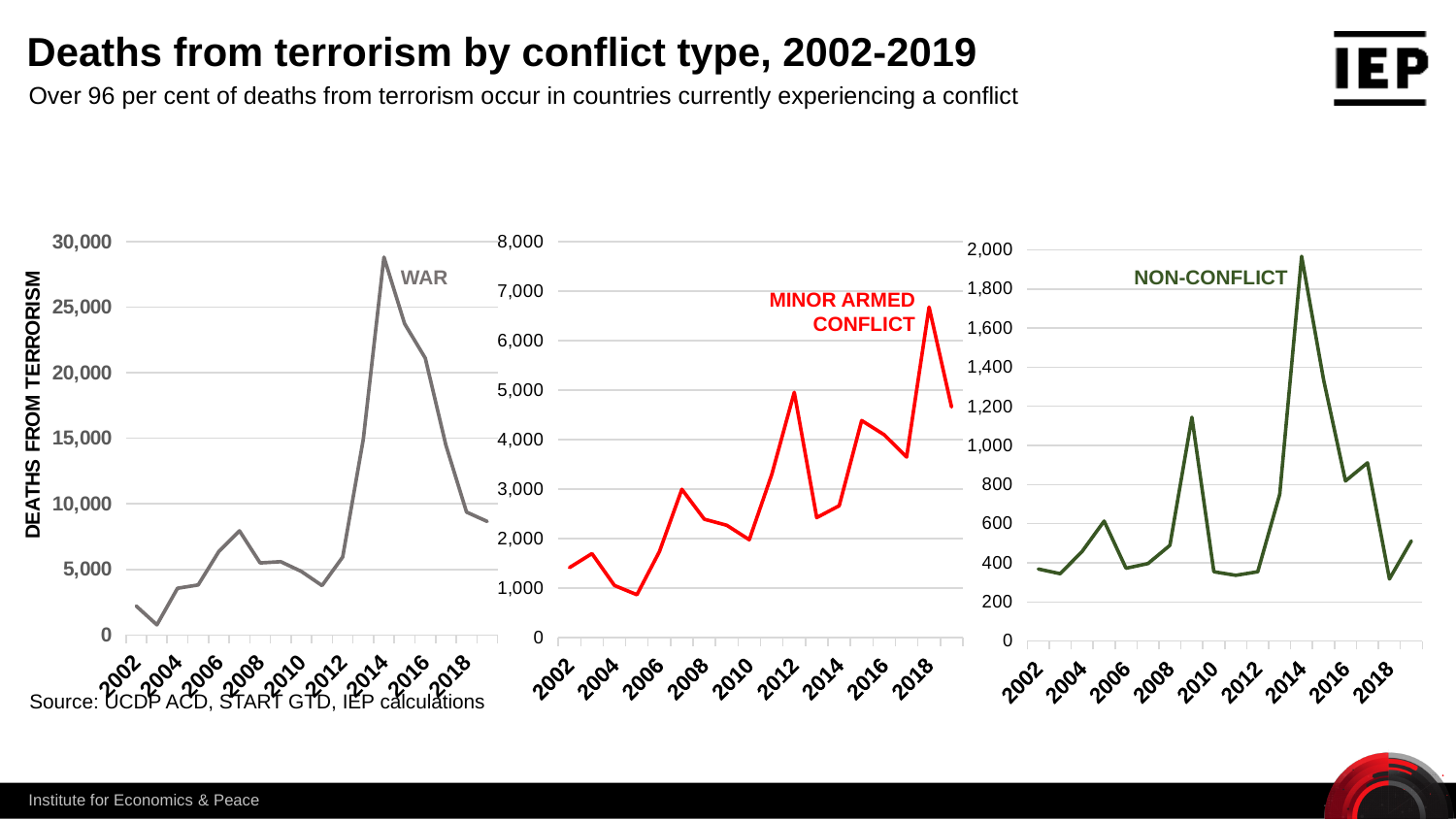
In the WAR chart, do deaths rise or fall from 2014 to 2018? fall In the WAR chart, is the value for 2002 greater or less than 5,000? less In the MINOR ARMED CONFLICT chart, is the value for 2002 greater or less than 1,000? greater In the MINOR ARMED CONFLICT chart, which year has the highest number of deaths? 2018 In the NON-CONFLICT chart, is the value for 2009 greater or less than 1,000? greater What kind of chart is used for the WAR panel on the slide? line chart In the WAR chart, which year has the highest number of deaths from terrorism? 2014 In the NON-CONFLICT chart, which year has the highest number of deaths? 2014 What colour is the line in the MINOR ARMED CONFLICT chart? red